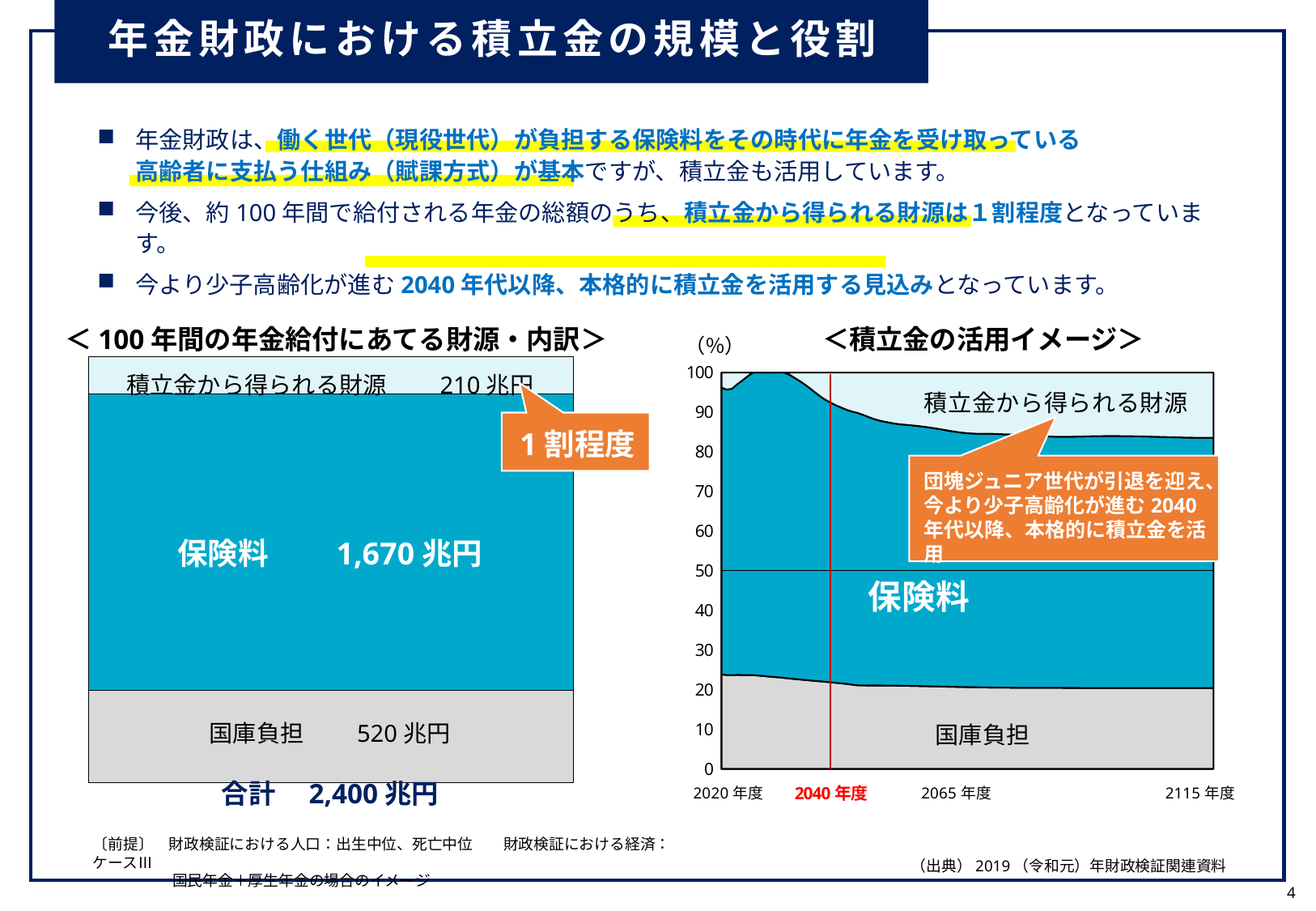
In the right chart <積立金の活用イメージ>, what kind of chart is it? Stacked area chart In the left chart <100年間の年金給付にあてる財源・内訳>, what is the value for 保険料? 1,670兆円 In the left chart <100年間の年金給付にあてる財源・内訳>, what is the difference between 保険料 and 国庫負担? 1,150兆円 In the left chart <100年間の年金給付にあてる財源・内訳>, what is the value for 積立金から得られる財源? 210兆円 In the right chart <積立金の活用イメージ>, does the share of 保険料 rise or fall from 2020年度 to 2115年度? fall In the left chart <100年間の年金給付にあてる財源・内訳>, which segment is the largest? 保険料 In the left chart <100年間の年金給付にあてる財源・内訳>, which segment is the smallest? 積立金から得られる財源 In the left chart <100年間の年金給付にあてる財源・内訳>, how many segments make up the stacked bar? 3 In the right chart <積立金の活用イメージ>, is the upper boundary of 国庫負担 at 2115年度 greater or less than 30? less In the left chart <100年間の年金給付にあてる財源・内訳>, what is the total of all segments? 2,400兆円 In the left chart <100年間の年金給付にあてる財源・内訳>, what is the value for 国庫負担? 520兆円 In the left chart <100年間の年金給付にあてる財源・内訳>, which is larger, 国庫負担 or 積立金から得られる財源? 国庫負担